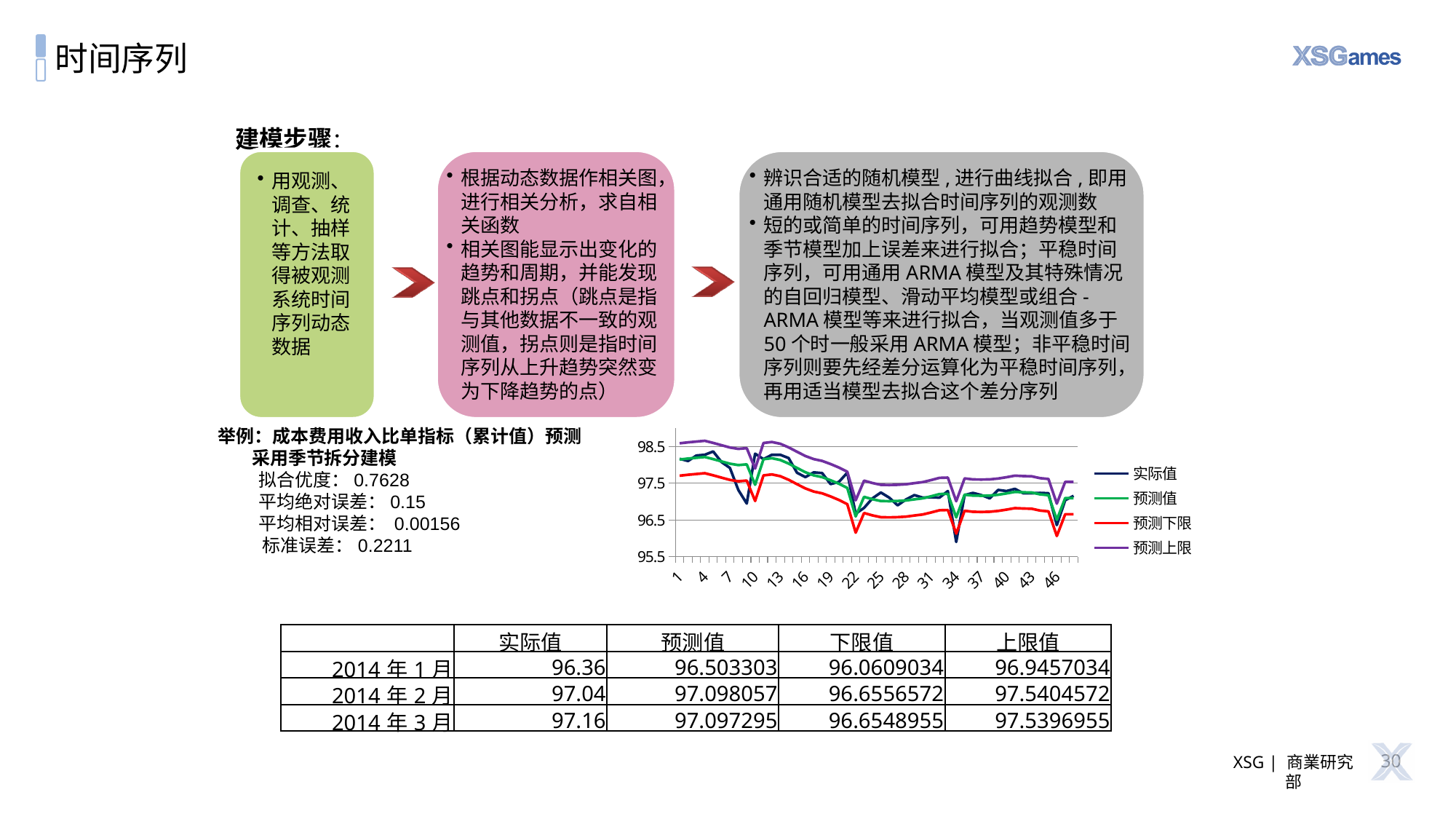
What is the highest tick label shown on the y axis of the chart? 98.5 At point 10, which is larger, 预测上限 or 预测下限? 预测上限 How many series does the chart legend list? 4 Which series is drawn in purple in the chart? 预测上限 At point 1, is the value for 实际值 greater or less than 97.5? greater What kind of chart is shown on the slide? line chart At point 1, is the value for 预测下限 greater or less than 97.5? greater At point 34, is the value for 实际值 greater or less than 96.5? less Which series lies highest across the chart? 预测上限 Which series is drawn in red in the chart? 预测下限 Do the plotted values generally rise or fall from left to right along the x axis? fall